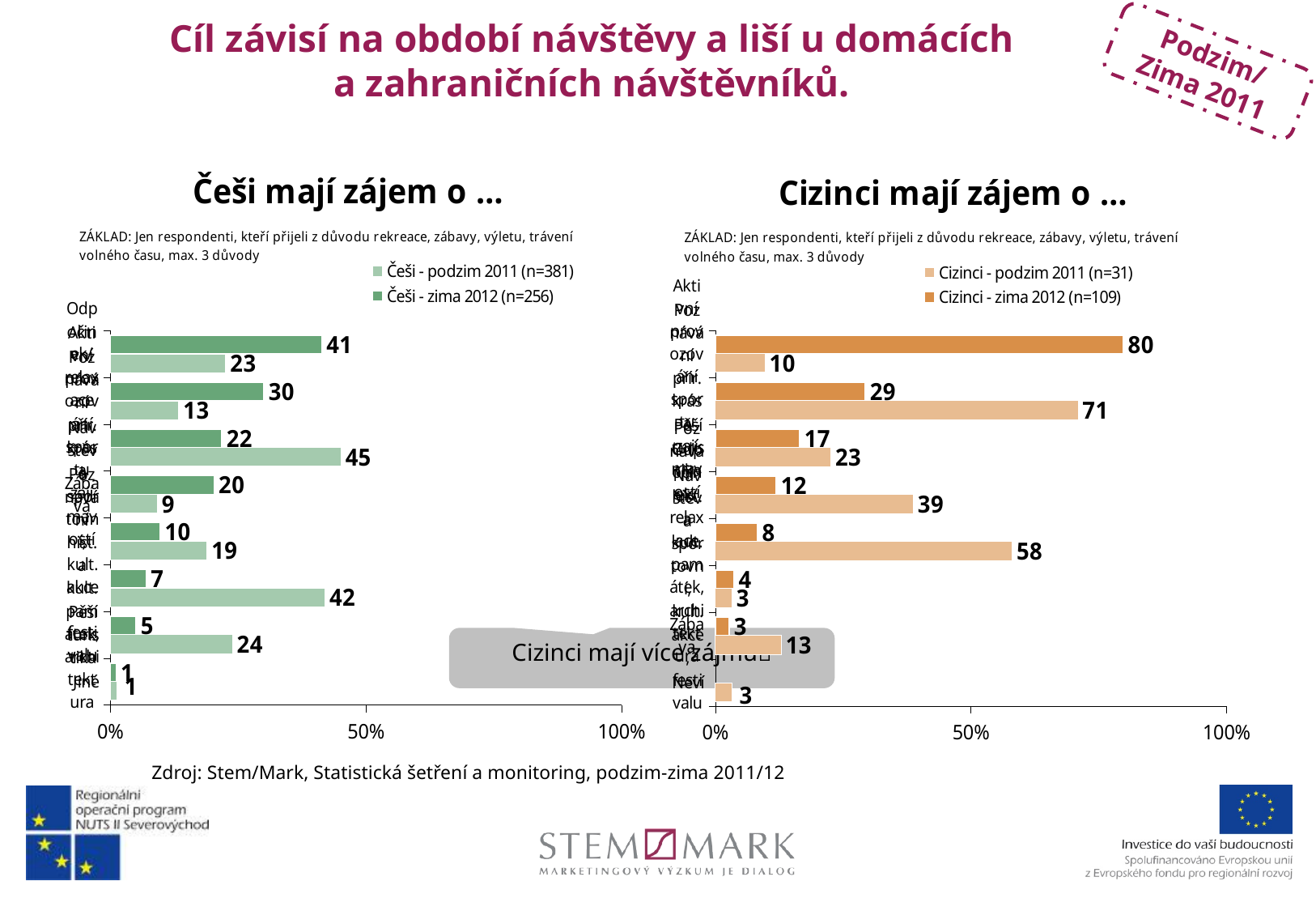
In the right chart "Cizinci mají zájem o …", what is the highest value shown for the series "Cizinci - zima 2012 (n=109)"? 80 What is the maximum value shown on the x axis of the left chart "Češi mají zájem o …"? 100% How many series does the legend of the left chart "Češi mají zájem o …" list? 2 In the left chart "Češi mají zájem o …", what is the highest value shown for the series "Češi - podzim 2011 (n=381)"? 45 In the left chart "Češi mají zájem o …", which series has the larger top value: "Češi - podzim 2011 (n=381)" or "Češi - zima 2012 (n=256)"? Češi - podzim 2011 (n=381) In the right chart "Cizinci mají zájem o …", is the highest value for "Cizinci - zima 2012 (n=109)" greater or less than 50%? greater In the right chart "Cizinci mají zájem o …", what is the difference between the highest value of "Cizinci - zima 2012 (n=109)" and the highest value of "Cizinci - podzim 2011 (n=31)"? 9 In the right chart "Cizinci mají zájem o …", what is the highest value shown for the series "Cizinci - podzim 2011 (n=31)"? 71 What is the sample size (n) given in the legend for "Cizinci - zima 2012" on the right chart? 109 What type of chart is used on the left chart titled "Češi mají zájem o …"? bar chart How many series does the legend of the right chart "Cizinci mají zájem o …" list? 2